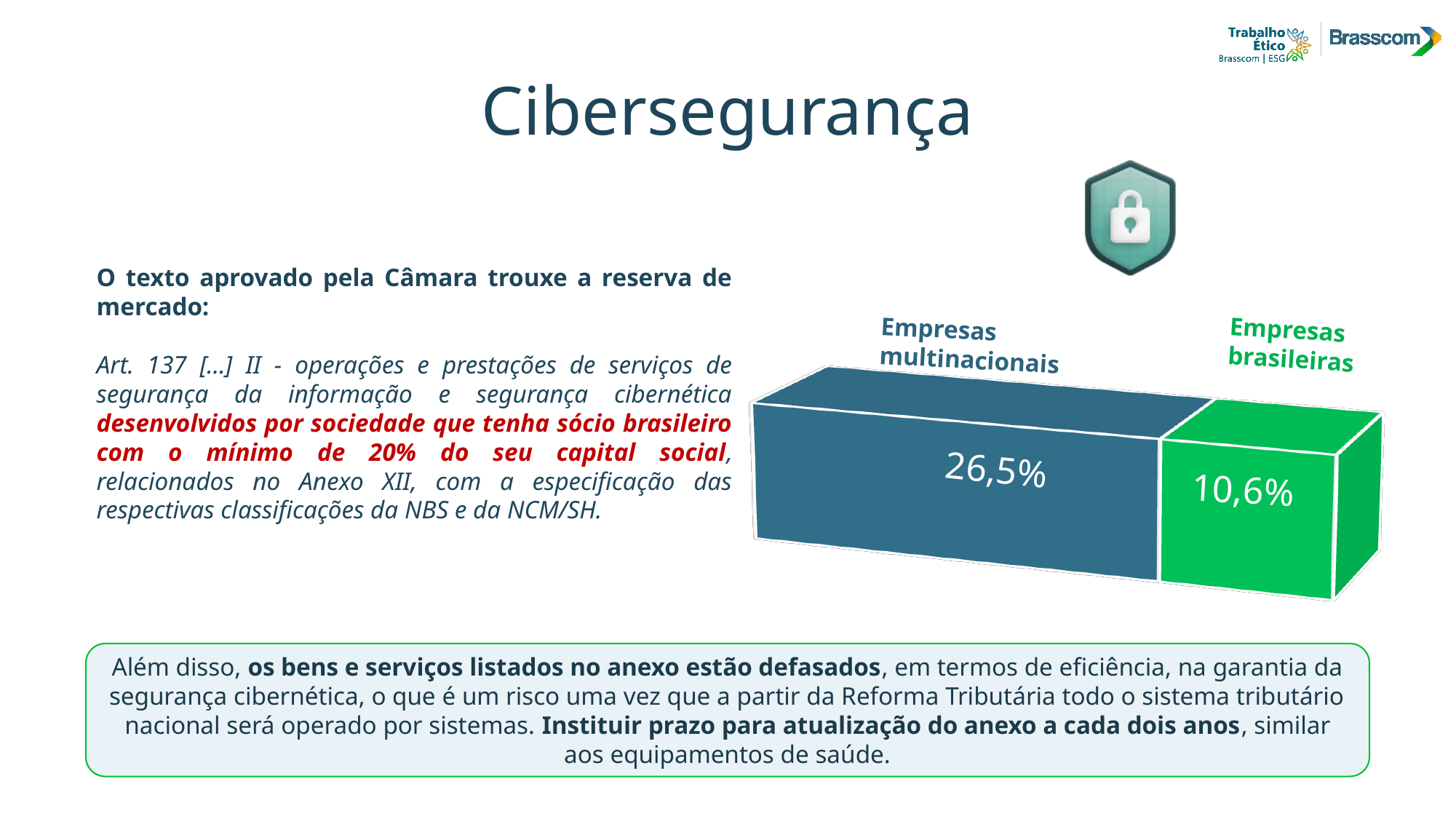
What kind of chart is shown on the slide? bar chart What colour is the segment for Empresas brasileiras? green Is the value for Empresas multinacionais larger or smaller than the value for Empresas brasileiras? larger Which segment of the bar has the higher value, Empresas multinacionais or Empresas brasileiras? Empresas multinacionais What is the difference between the values for Empresas multinacionais and Empresas brasileiras? 15,9% What value is shown for Empresas brasileiras? 10,6% What value is shown for Empresas multinacionais? 26,5% Which segment of the bar has the lower value? Empresas brasileiras What is the total of the two segments in the stacked bar? 37,1% How many segments does the stacked bar contain? 2 What colour is the segment for Empresas multinacionais? dark blue